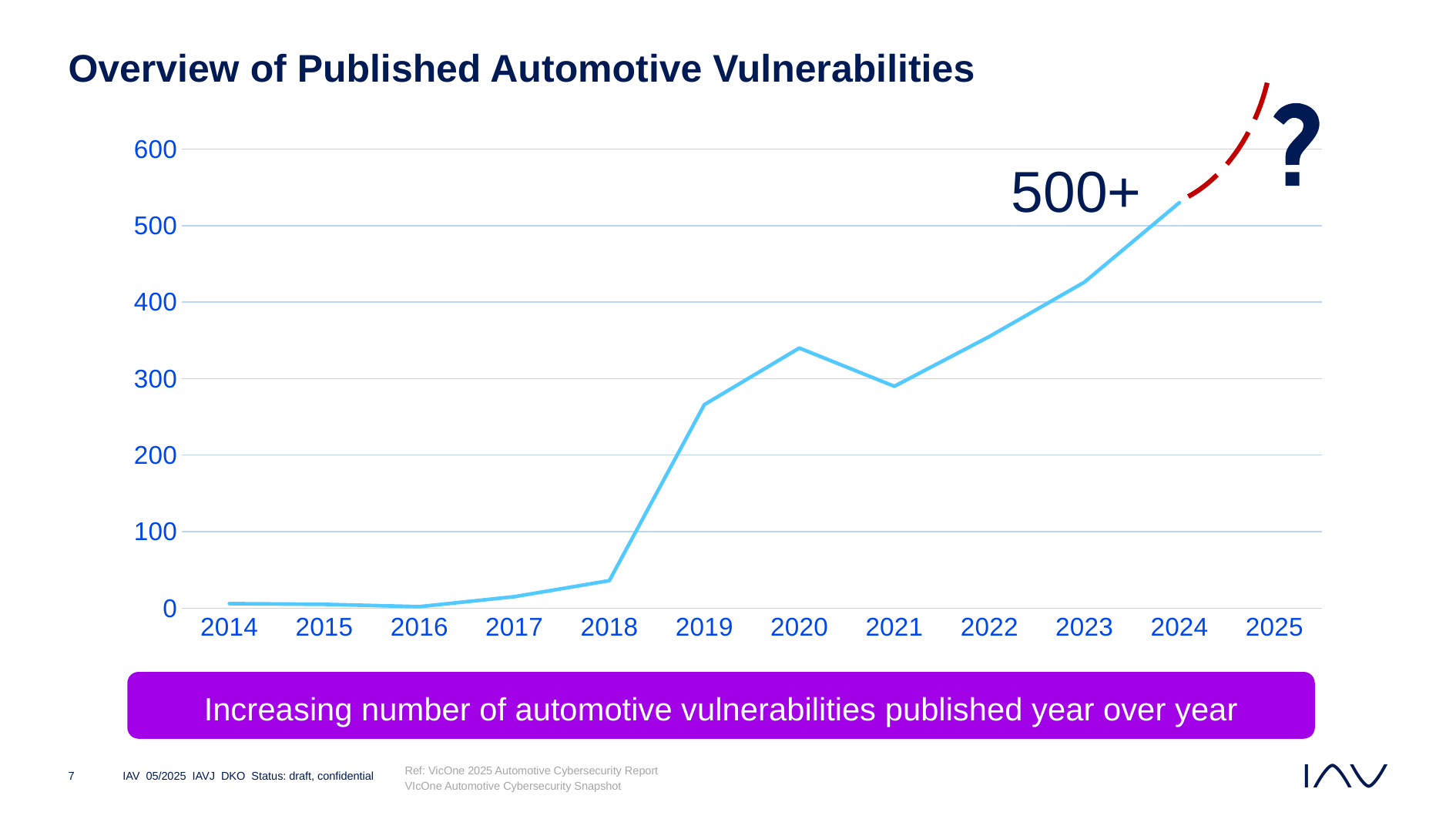
What text annotation is printed next to the 2024 end of the line? 500+ Is the value for 2024 greater or less than 500? greater Is the value for 2023 greater or less than 400? greater Is the value for 2018 greater or less than 100? less What is the title of the chart? Overview of Published Automotive Vulnerabilities What kind of chart is shown on the slide? line chart How many year labels are shown on the x axis? 12 Do the values generally rise or fall from 2014 to 2024? rise Which year has the highest value on the solid line? 2024 Which year has the larger value, 2020 or 2021? 2020